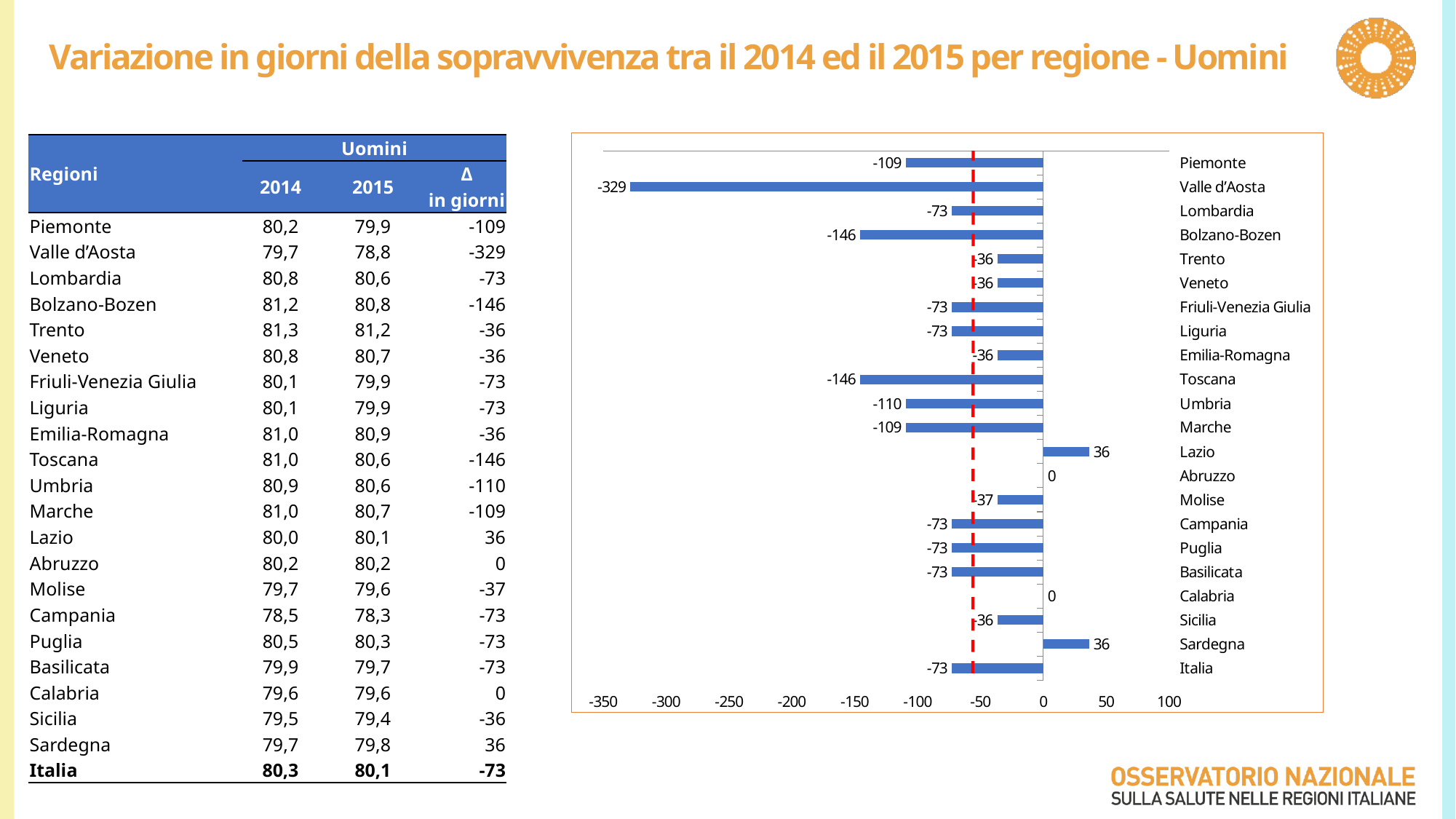
What is the value shown for Italia in the chart? -73 What is the difference between the values for Piemonte and Valle d'Aosta in the chart? 220 What is the value shown for Umbria in the chart? -110 Which has the larger value in the chart, Molise or Toscana? Molise How many regions (categories) are plotted in the chart? 22 What is the difference between the values for Bolzano-Bozen and Lombardia in the chart? 73 Which region has the lowest value in the chart? Valle d'Aosta What is the value shown for Lazio in the chart? 36 What is the value shown for Valle d'Aosta in the chart? -329 What is the value shown for Bolzano-Bozen in the chart? -146 What kind of chart is shown on the slide? bar chart Is the value for Valle d'Aosta greater or less than -300? less